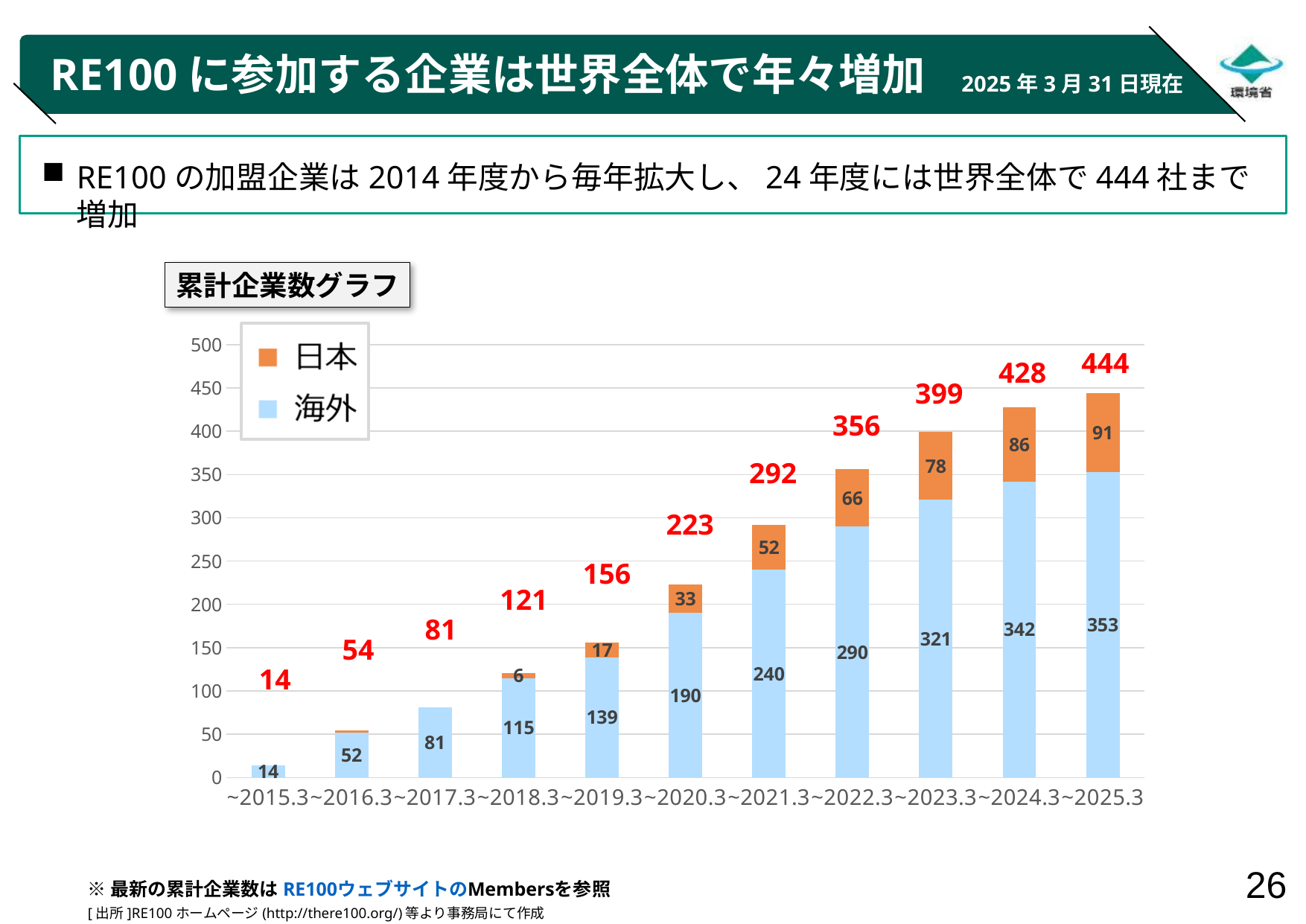
Which category has the lowest total? ~2015.3 How many series does the legend list? 2 What kind of chart is shown? stacked bar chart Do the totals rise or fall from ~2015.3 to ~2025.3? rise What is the 日本 value for ~2022.3? 66 How many categories are shown on the x axis? 11 Which is larger, the 日本 value for ~2020.3 or the 日本 value for ~2019.3? ~2020.3 What is the total shown above the stacked bar for ~2021.3? 292 Which category has the highest total? ~2025.3 What is the 海外 value for ~2025.3? 353 Is the total for ~2022.3 greater or less than 350? greater What is the difference between the 海外 values for ~2024.3 and ~2023.3? 21